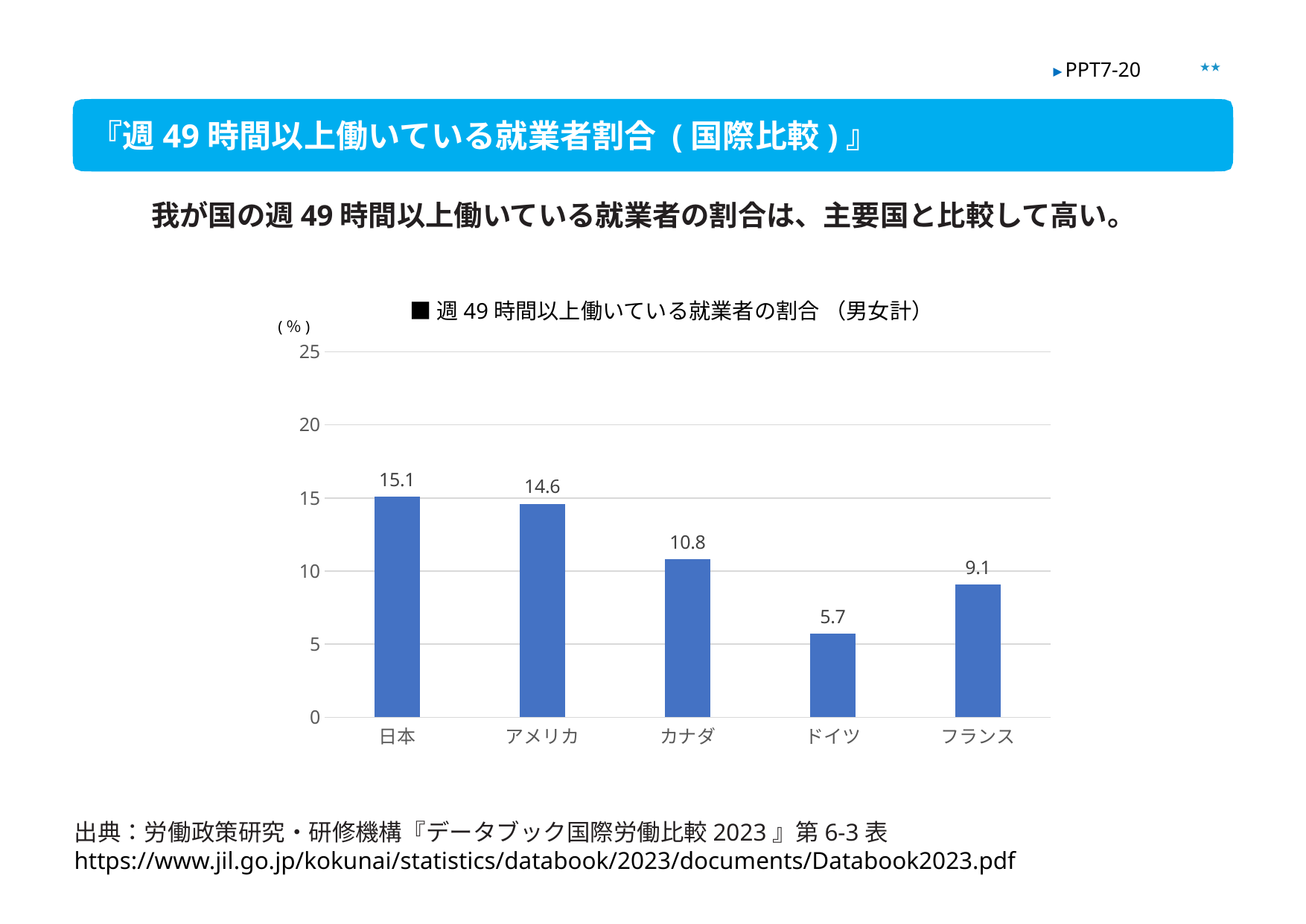
Which is larger, the value for カナダ or the value for フランス? カナダ How many countries are shown in the chart? 5 What unit is shown on the vertical axis of the chart? % Is the value for アメリカ greater or less than 10? greater What kind of chart is shown on the slide? bar chart What is the difference between the values for カナダ and ドイツ? 5.1 What is the value for 日本? 15.1 What is the value for ドイツ? 5.7 Which country has the lowest value? ドイツ What is the value for フランス? 9.1 Which country has the highest value? 日本 What is the difference between the values for 日本 and アメリカ? 0.5